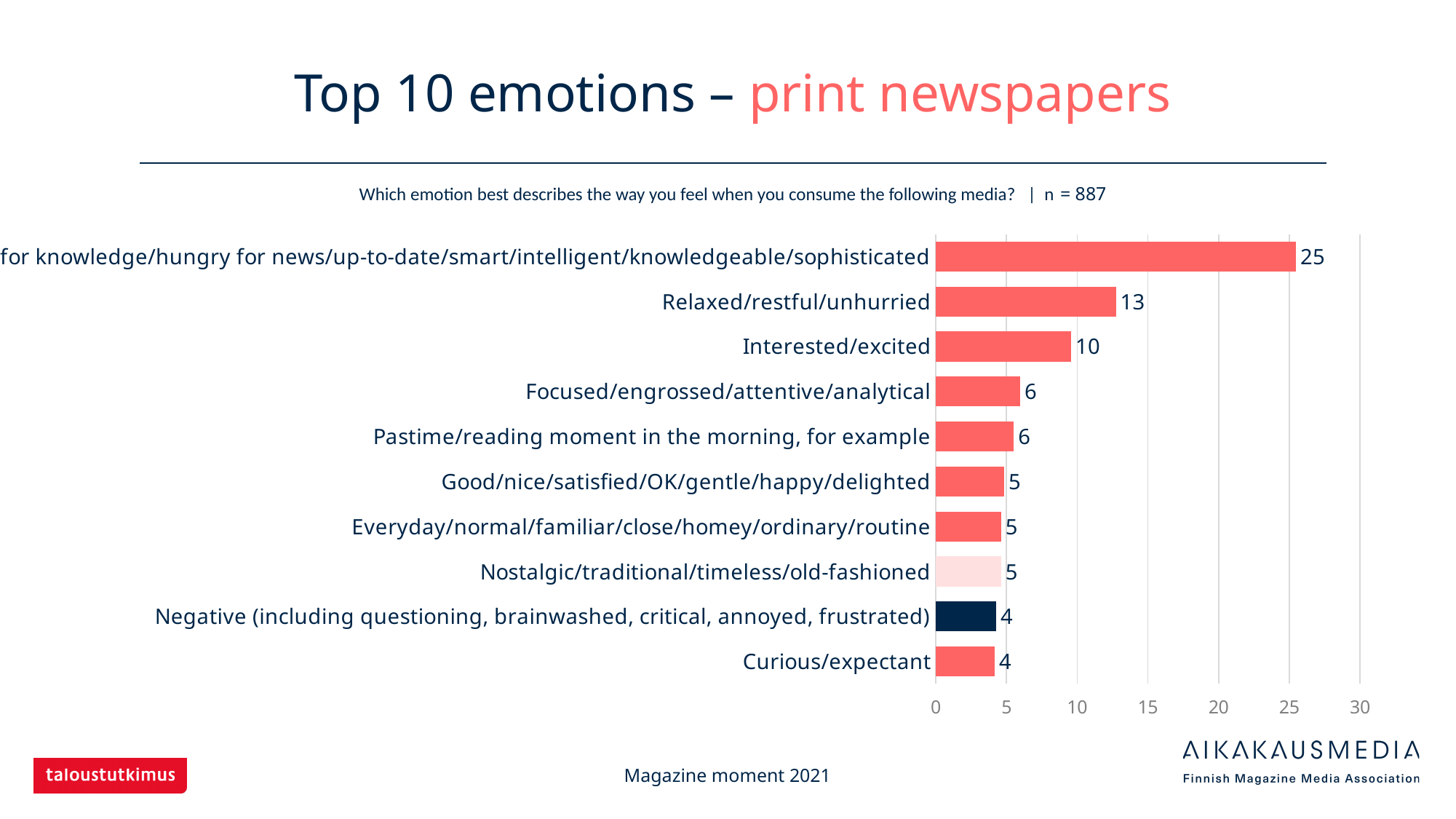
What is the lowest value shown in the chart? 4 What is the value for Relaxed/restful/unhurried? 13 Do the bar values increase or decrease from the top of the chart to the bottom? Decrease What is the value for Interested/excited? 10 How many emotion categories are shown in the chart? 10 What is the value for Nostalgic/traditional/timeless/old-fashioned? 5 What is the highest value shown in the chart? 25 What is the difference between the values for Relaxed/restful/unhurried and Interested/excited? 3 What is the value for Negative (including questioning, brainwashed, critical, annoyed, frustrated)? 4 What kind of chart is shown on the slide? Bar chart Which category's bar is coloured dark navy instead of red? Negative (including questioning, brainwashed, critical, annoyed, frustrated) Which has a larger value: Focused/engrossed/attentive/analytical or Good/nice/satisfied/OK/gentle/happy/delighted? Focused/engrossed/attentive/analytical